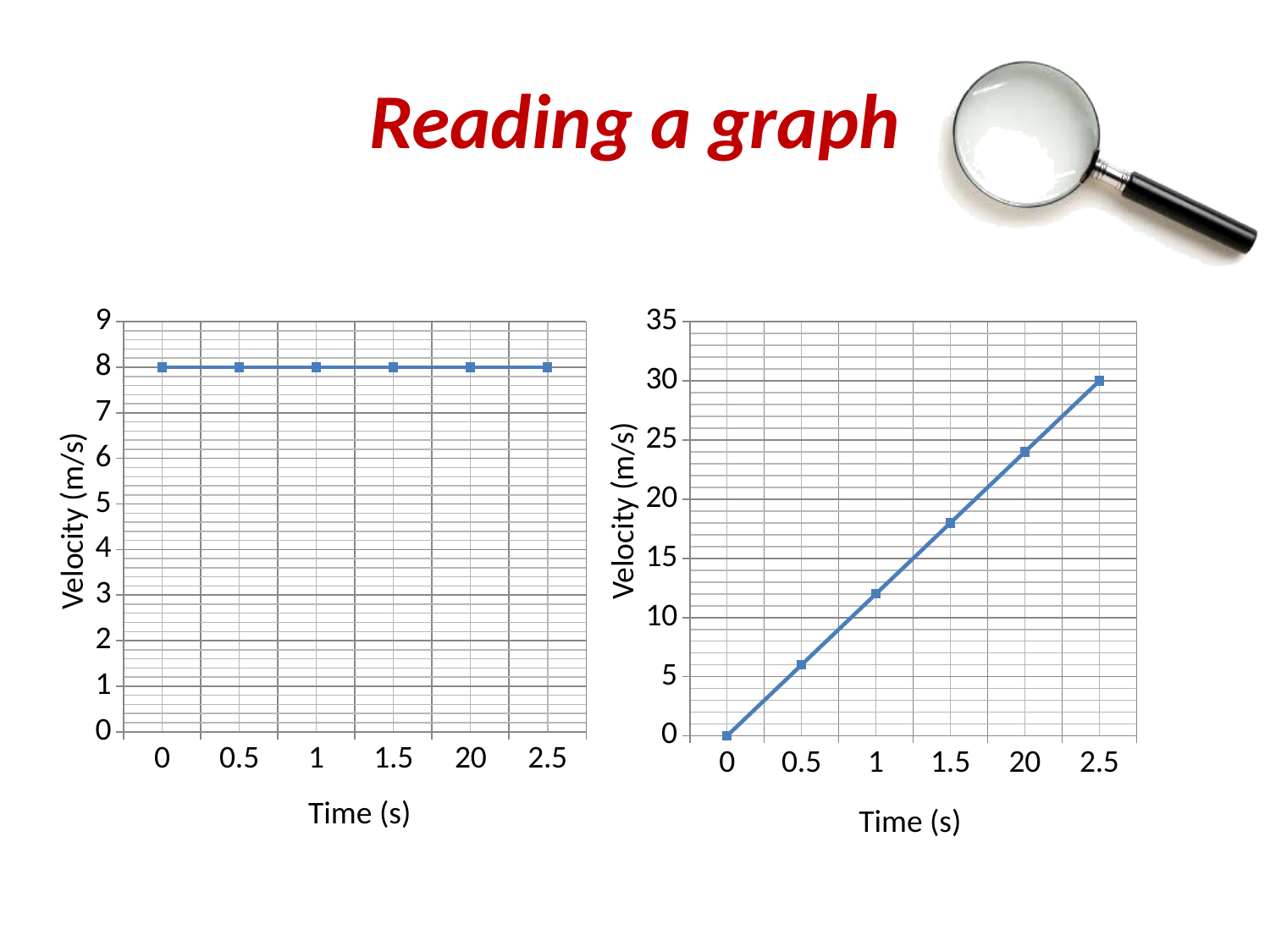
In the chart on the right, what is the velocity at time 0 s? 0 What is the y-axis label on the chart on the right? Velocity (m/s) In the chart on the left, what is the velocity at time 1 s? 8 In the chart on the right, at which time is the velocity highest? 2.5 In the chart on the right, does the velocity rise or fall as time increases? rises In the chart on the left, does the velocity rise, fall or stay constant as time increases? stays constant In the chart on the right, is the velocity at time 0.5 s greater or less than 10? less In the chart on the right, which has the larger velocity: time 1 s or time 2.5 s? 2.5 s In the chart on the right, what is the velocity at time 2.5 s? 30 What kind of chart is the chart on the left of the slide? line chart In the chart on the right, is the velocity at time 1.5 s greater or less than 15? greater How many data points are plotted in the chart on the left? 6